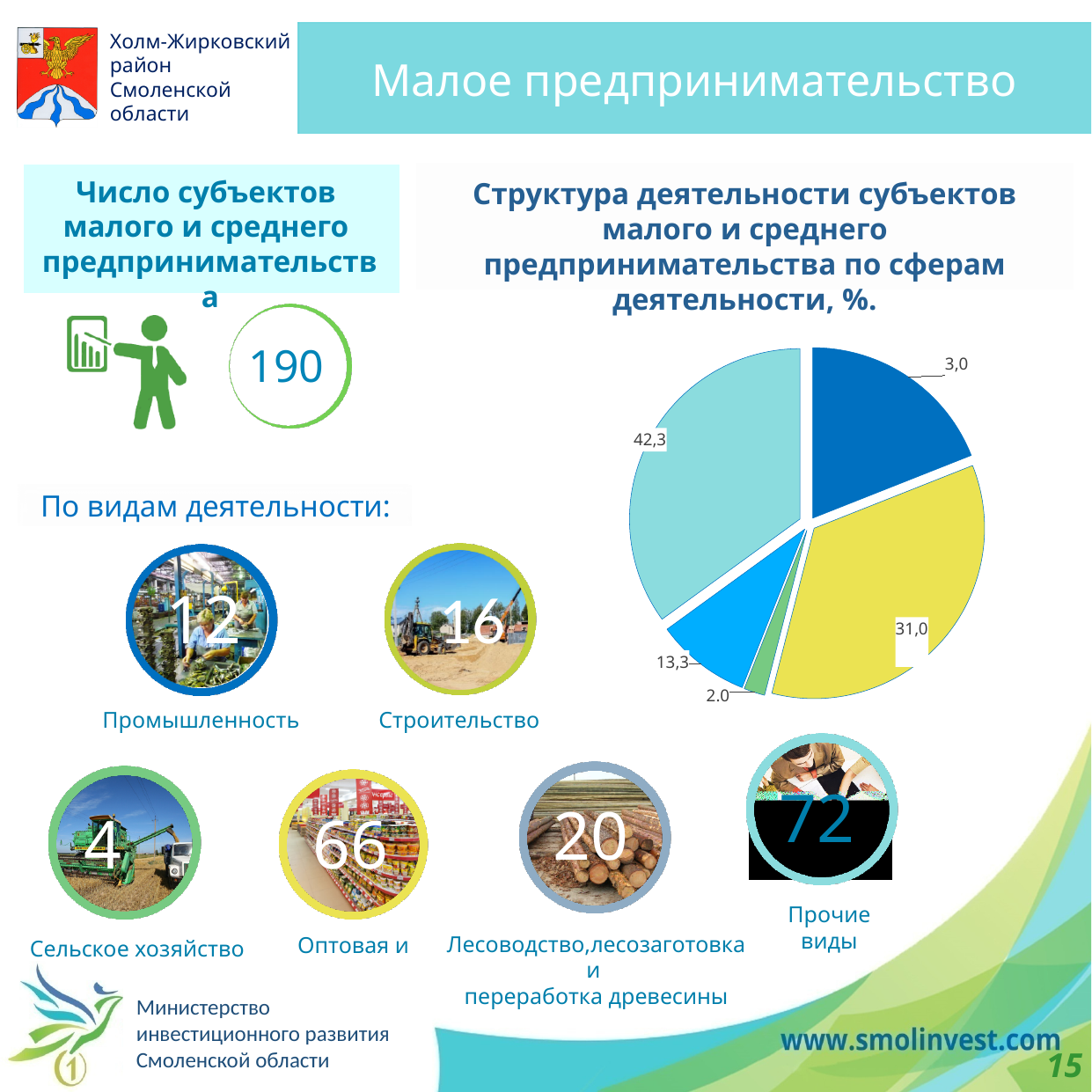
What is the largest value labelled on the pie chart? 42,3 What value is labelled on the bright blue slice at the lower left of the pie chart? 13,3 Which is larger on the pie chart: the yellow slice (31,0) or the bright blue slice (13,3)? the yellow slice (31,0) What is the difference between the two largest labelled values on the pie chart, 42,3 and 31,0? 11,3 What value is labelled on the small green slice of the pie chart? 2.0 What is the smallest value labelled on the pie chart? 2.0 What is the title of the pie chart? Структура деятельности субъектов малого и среднего предпринимательства по сферам деятельности, %. How many data labels are printed on the pie chart? 5 What share of the pie does the largest slice represent? 42,3% What value is labelled on the yellow slice of the pie chart? 31,0 What kind of chart is shown on the slide? pie chart What value is labelled on the large light-cyan slice of the pie chart? 42,3